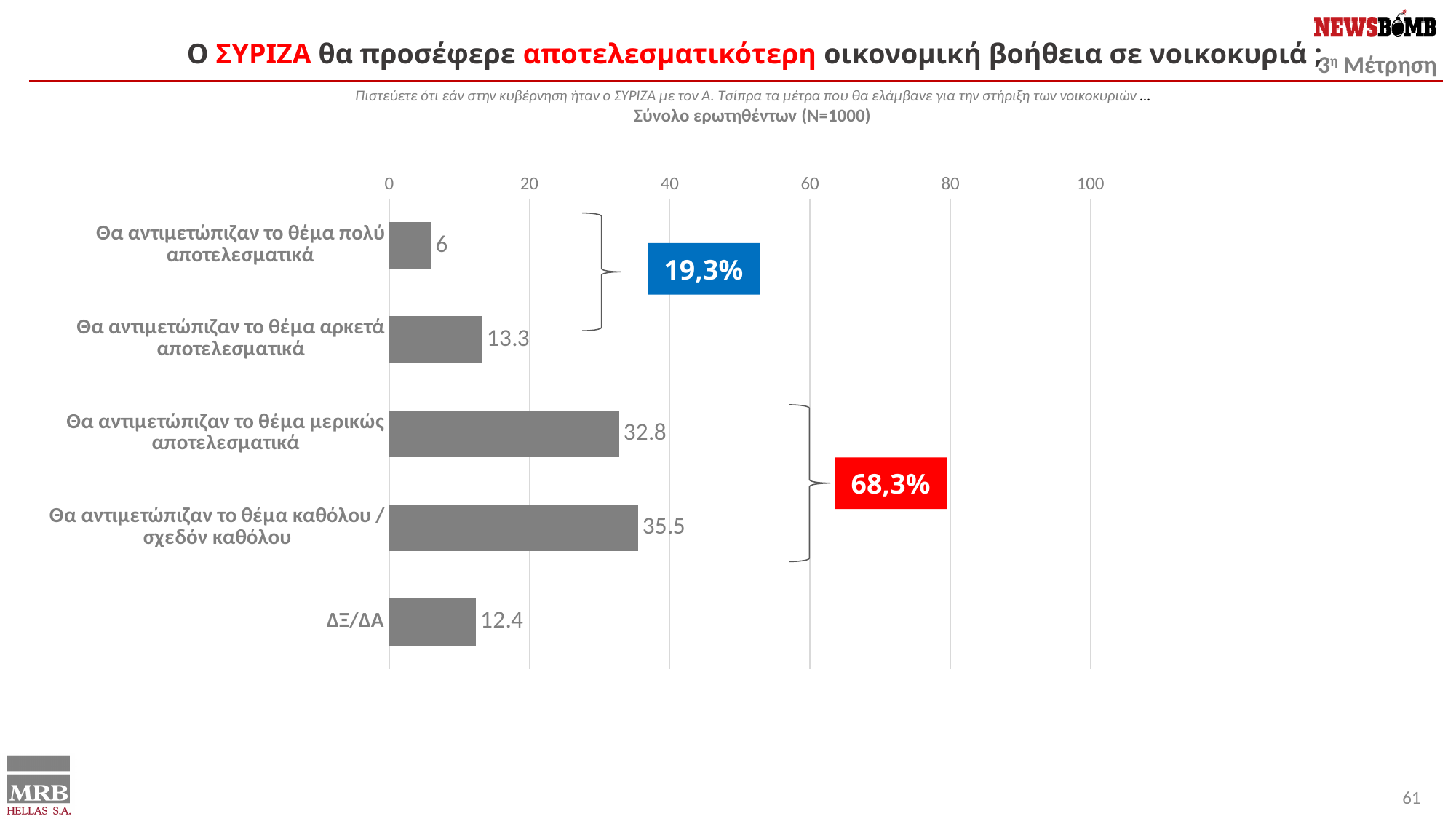
Which category has the lowest value? Θα αντιμετώπιζαν το θέμα πολύ αποτελεσματικά What is the value for "Θα αντιμετώπιζαν το θέμα μερικώς αποτελεσματικά"? 32.8 What is the value for "Θα αντιμετώπιζαν το θέμα αρκετά αποτελεσματικά"? 13.3 What is the value for "ΔΞ/ΔΑ"? 12.4 Which is larger: the value for "αρκετά αποτελεσματικά" or the value for "ΔΞ/ΔΑ"? αρκετά αποτελεσματικά Which category has the highest value? Θα αντιμετώπιζαν το θέμα καθόλου / σχεδόν καθόλου Is the value for "Θα αντιμετώπιζαν το θέμα μερικώς αποτελεσματικά" greater or less than 20? greater What percentage is shown in the red box bracketing the "μερικώς" and "καθόλου / σχεδόν καθόλου" bars? 68,3% How many categories are shown in the chart? 5 What is the value for "Θα αντιμετώπιζαν το θέμα πολύ αποτελεσματικά"? 6 What is the difference between the values for "καθόλου / σχεδόν καθόλου" and "μερικώς αποτελεσματικά"? 2.7 What kind of chart is shown on the slide? bar chart